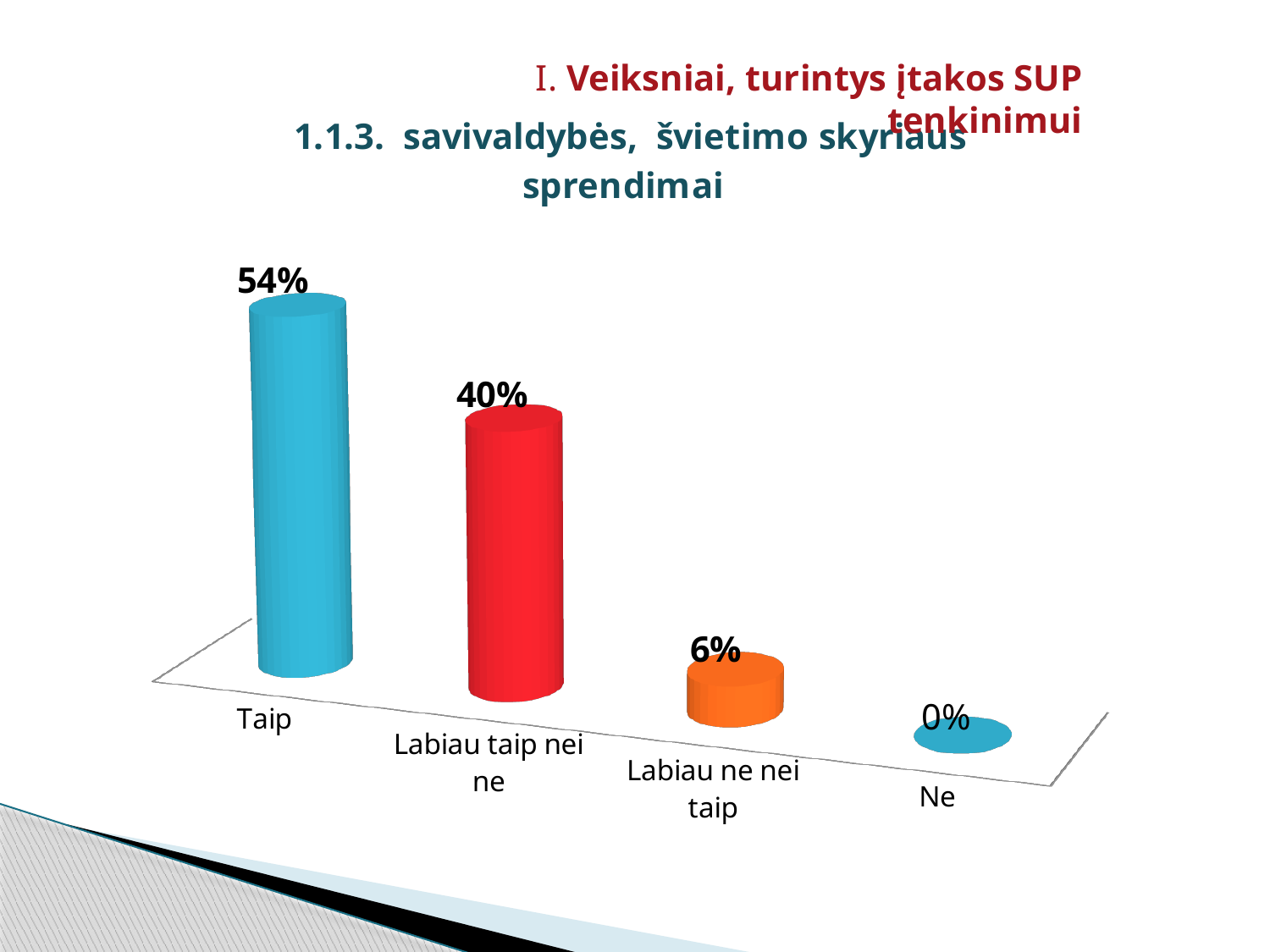
What is the value for "Ne"? 0% Which is larger, the value for "Labiau ne nei taip" or the value for "Ne"? Labiau ne nei taip What is the value for "Taip"? 54% Which category has the lowest value? Ne What is the difference between the values for "Labiau taip nei ne" and "Labiau ne nei taip"? 34% Which category has the highest value? Taip What is the difference between the values for "Taip" and "Labiau taip nei ne"? 14% How many categories are shown in the chart? 4 What is the value for "Labiau taip nei ne"? 40% What is the value for "Labiau ne nei taip"? 6% What kind of chart is shown on the slide? Bar chart Do the values rise or fall from left to right along the x axis? Fall